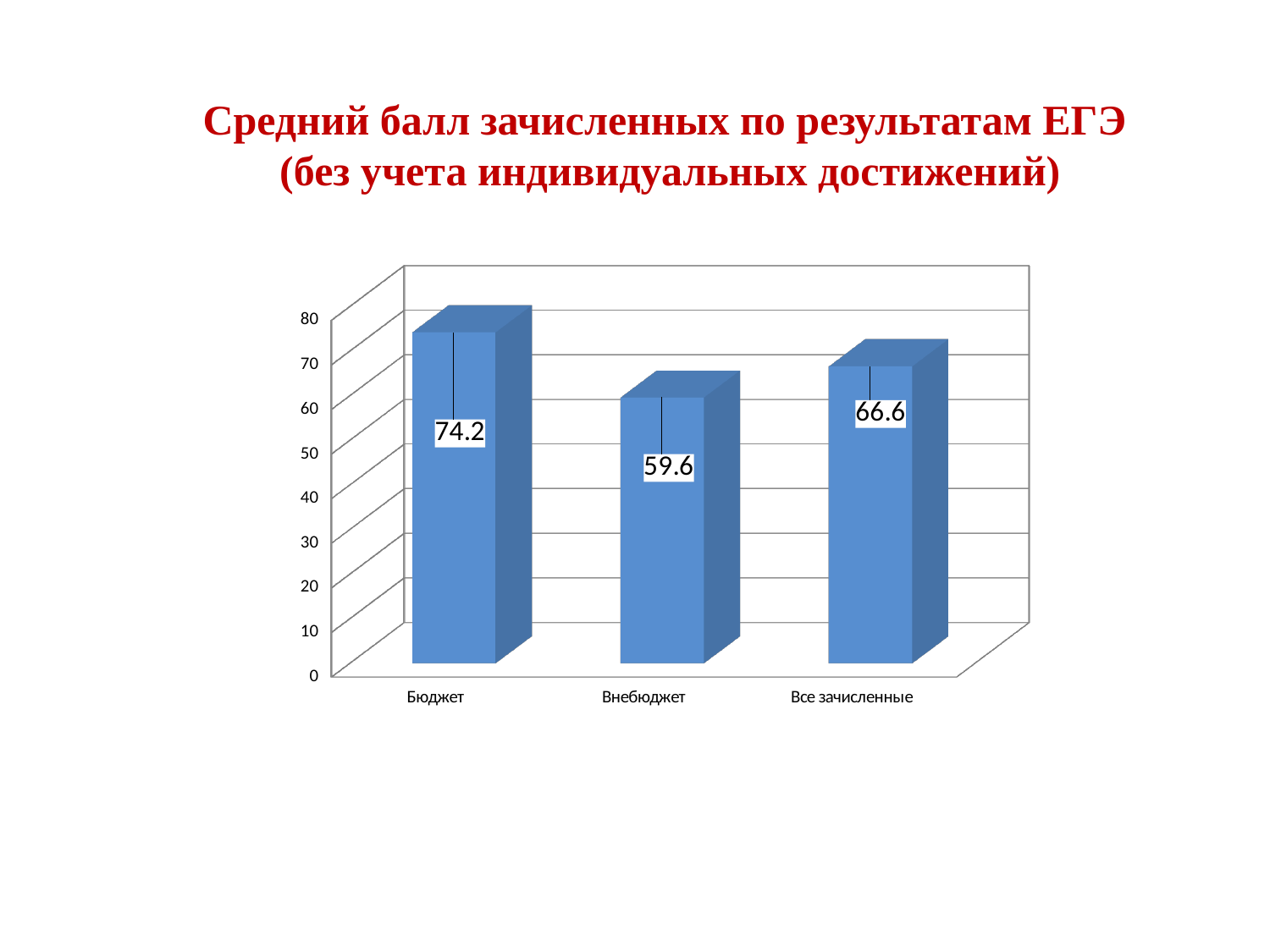
Which category has the highest value? Бюджет Which category has the lowest value? Внебюджет What is the title of the slide? Средний балл зачисленных по результатам ЕГЭ (без учета индивидуальных достижений) What is the difference between the values for Бюджет and Внебюджет? 14.6 What is the difference between the values for Бюджет and Все зачисленные? 7.6 Is the value for Внебюджет greater or less than 60? less What is the value for Внебюджет? 59.6 What is the value for Бюджет? 74.2 How many categories are shown on the chart? 3 What kind of chart is shown on the slide? bar chart Which is larger, the value for Внебюджет or the value for Все зачисленные? Все зачисленные What is the value for Все зачисленные? 66.6